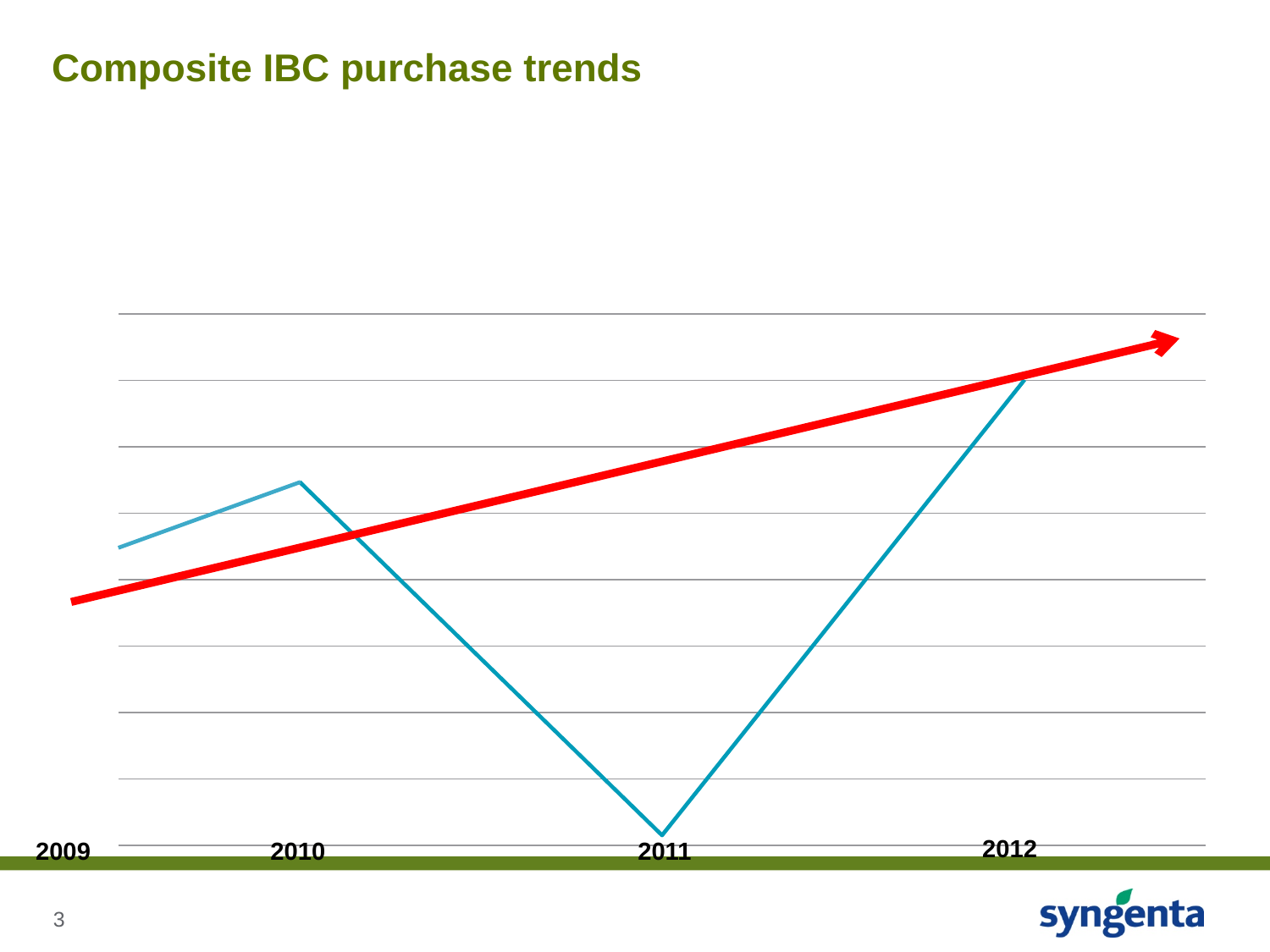
Does the blue line rise or fall from 2010 to 2011? Fall Which year has the larger value on the blue line, 2010 or 2012? 2012 What colour is the data line plotted on the chart? Blue Which year has the larger value on the blue line, 2009 or 2010? 2010 Does the red arrow drawn over the chart point upward or downward from left to right? Upward Which year has the lowest value on the blue line? 2011 Which year has the highest value on the blue line? 2012 What kind of chart is shown on the slide? Line chart How many years are shown on the x axis of the chart? 4 What is the first year shown on the x axis of the chart? 2009 What is the title of the chart on the slide? Composite IBC purchase trends Does the blue line rise or fall from 2011 to 2012? Rise